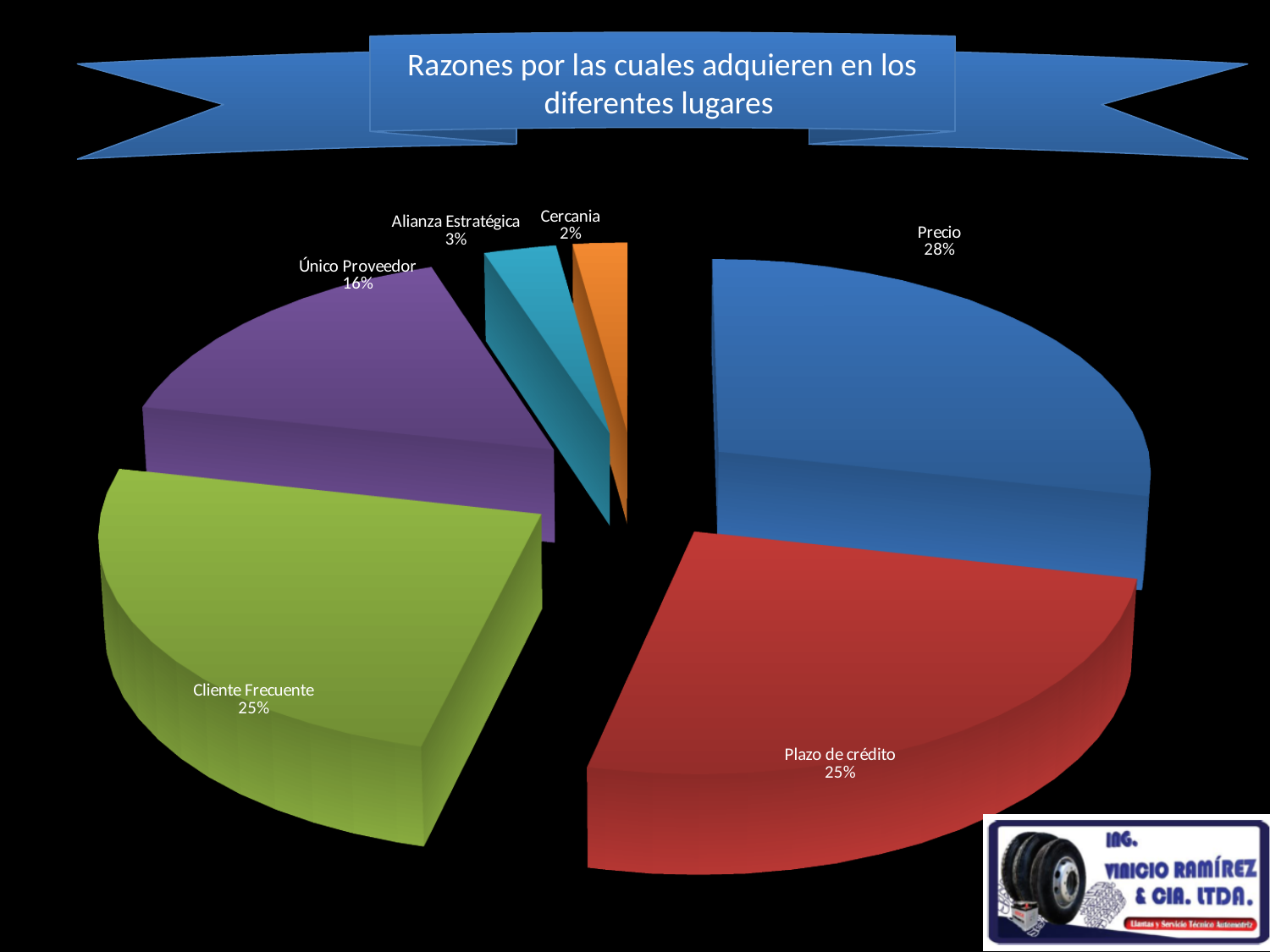
What colour is the Plazo de crédito slice? Red Which category has the largest share of the pie? Precio What percentage is shown for Alianza Estratégica? 3% What percentage is shown for Cercania? 2% What percentage is shown for Único Proveedor? 16% What type of chart is shown on the slide? Pie chart Which category has the smallest share of the pie? Cercania What is the title of the chart? Razones por las cuales adquieren en los diferentes lugares What share of the pie does Precio represent? 28% How many categories are shown in the pie chart? 6 What is the difference in percentage points between Precio and Único Proveedor? 12 Which is larger, the share for Cliente Frecuente or the share for Único Proveedor? Cliente Frecuente